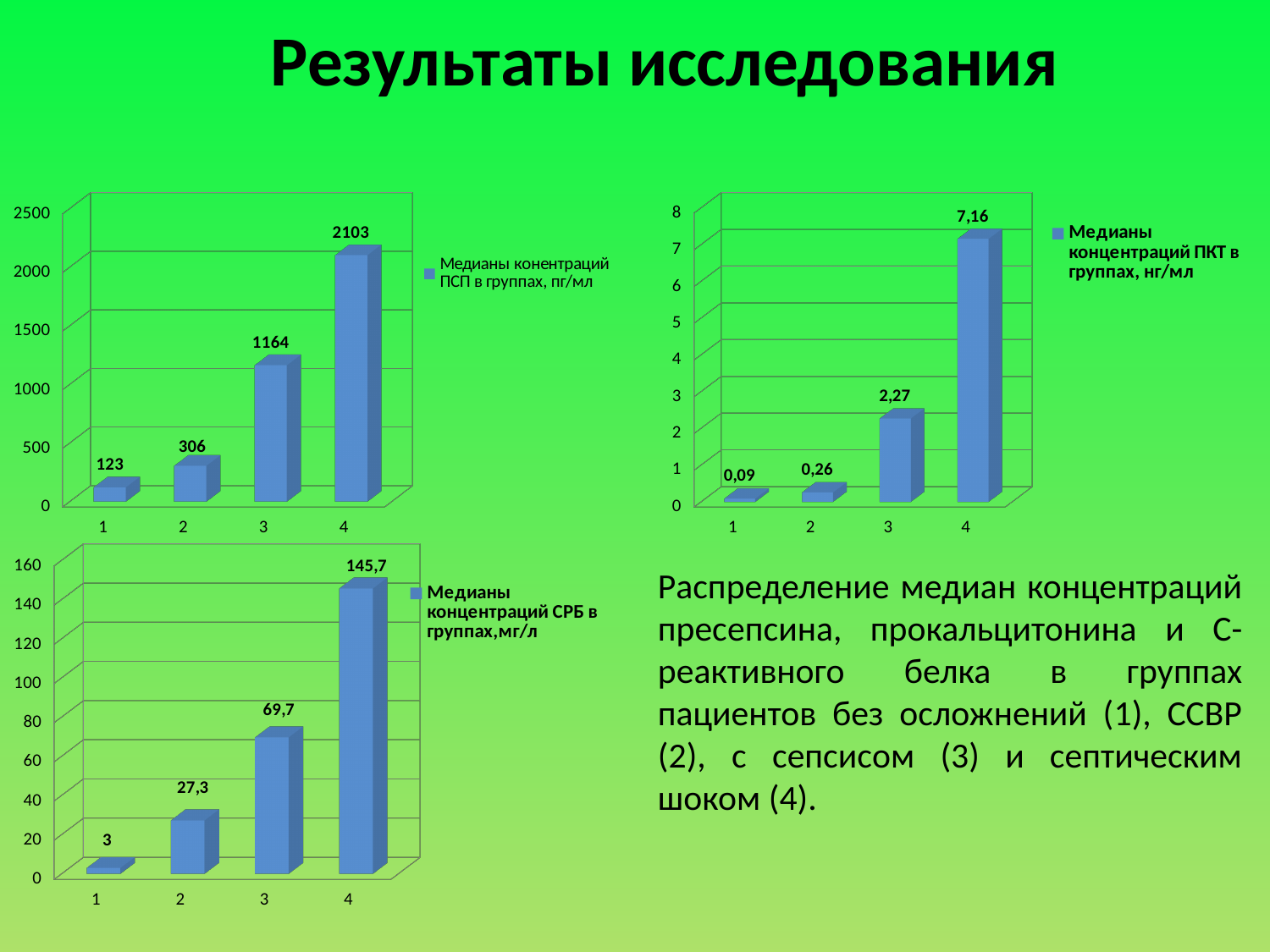
In the bottom-left chart (Медианы концентраций СРБ в группах, мг/л), what is the value for group 2? 27,3 In the top-left chart (Медианы конентраций ПСП в группах, пг/мл), what is the value for group 3? 1164 In the top-left chart (Медианы конентраций ПСП в группах, пг/мл), which group has the highest value? 4 In the top-left chart (Медианы конентраций ПСП в группах, пг/мл), what is the difference between the values for group 4 and group 3? 939 In the top-right chart (Медианы концентраций ПКТ в группах, нг/мл), is the value for group 4 greater or less than 7? greater In the bottom-left chart (Медианы концентраций СРБ в группах, мг/л), which is larger, the value for group 3 or group 4? group 4 What kind of chart is the top-right chart (Медианы концентраций ПКТ в группах, нг/мл)? bar chart In the top-right chart (Медианы концентраций ПКТ в группах, нг/мл), which group has the lowest value? 1 How many series does the legend of the top-left chart list? 1 How many groups are shown on the x axis of the bottom-left chart (Медианы концентраций СРБ в группах, мг/л)? 4 In the top-right chart (Медианы концентраций ПКТ в группах, нг/мл), what is the value for group 2? 0,26 In the bottom-left chart (Медианы концентраций СРБ в группах, мг/л), do the values rise or fall from group 1 to group 4? rise